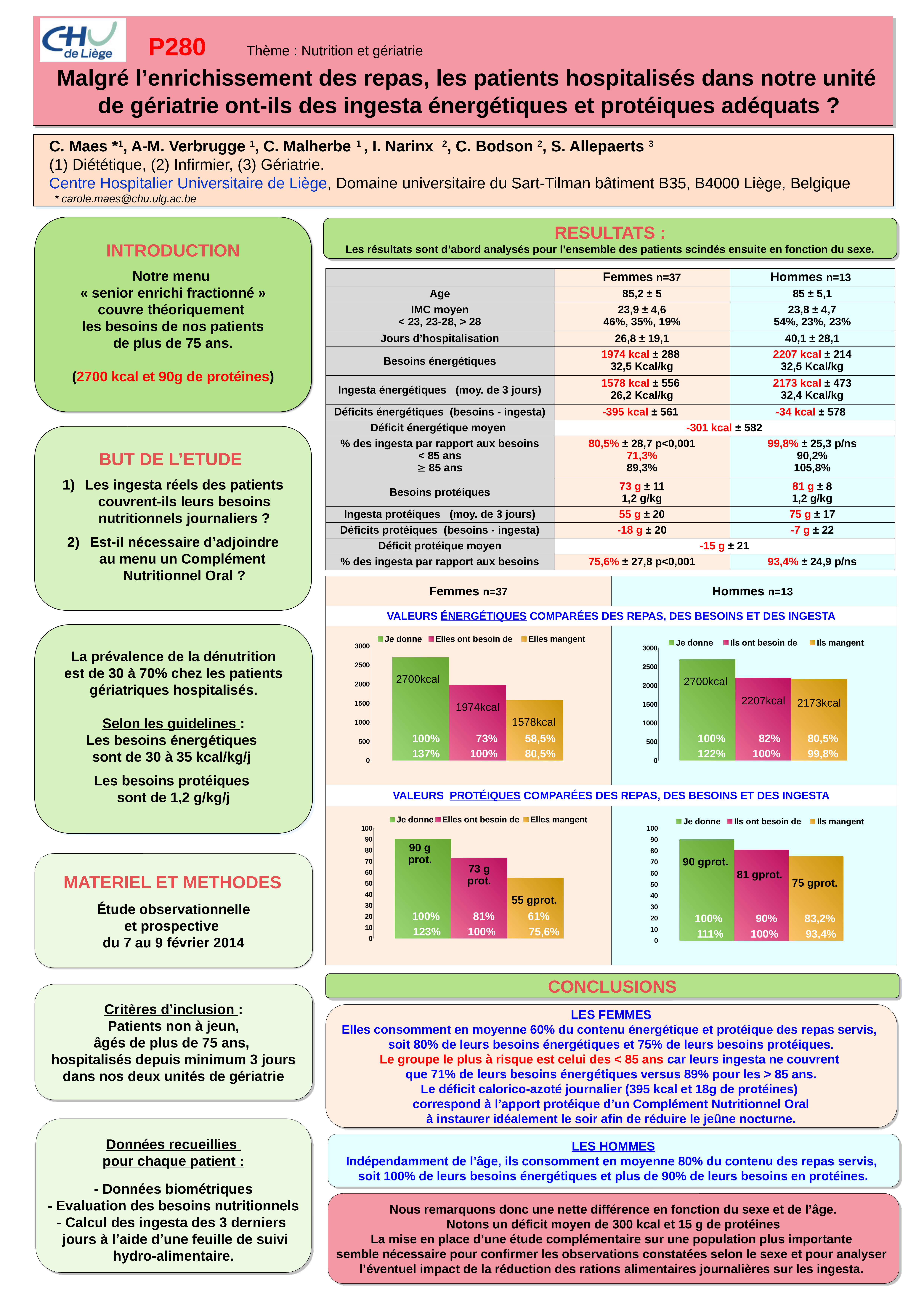
How many series does the legend of the women's protein chart (bottom-left chart) list? 3 In the men's protein chart (bottom-right chart, Hommes n=13), what value is shown for 'Ils ont besoin de'? 81 gprot. In the men's protein chart (bottom-right chart), which is larger: 'Ils ont besoin de' or 'Ils mangent'? Ils ont besoin de In the men's energy chart (top-right chart, Hommes n=13), what value is shown for 'Ils ont besoin de'? 2207kcal In the women's energy chart (top-left chart, Femmes n=37), what value is shown for 'Elles mangent'? 1578kcal In the women's protein chart (bottom-left chart), do the bar values rise or fall from left to right? Fall In the women's protein chart (bottom-left chart, Femmes n=37), what value is shown for 'Elles mangent'? 55 gprot. In the women's energy chart (top-left chart), what is the difference in kcal between 'Elles ont besoin de' and 'Elles mangent'? 396 kcal In the women's energy chart (top-left chart), which bar is the lowest? Elles mangent What type of chart is the men's energy chart (top-right chart)? Bar chart In the men's energy chart (top-right chart, Hommes n=13), what value is shown for 'Ils mangent'? 2173kcal In the women's energy chart (top-left chart, Femmes n=37), what value is shown for 'Je donne'? 2700kcal